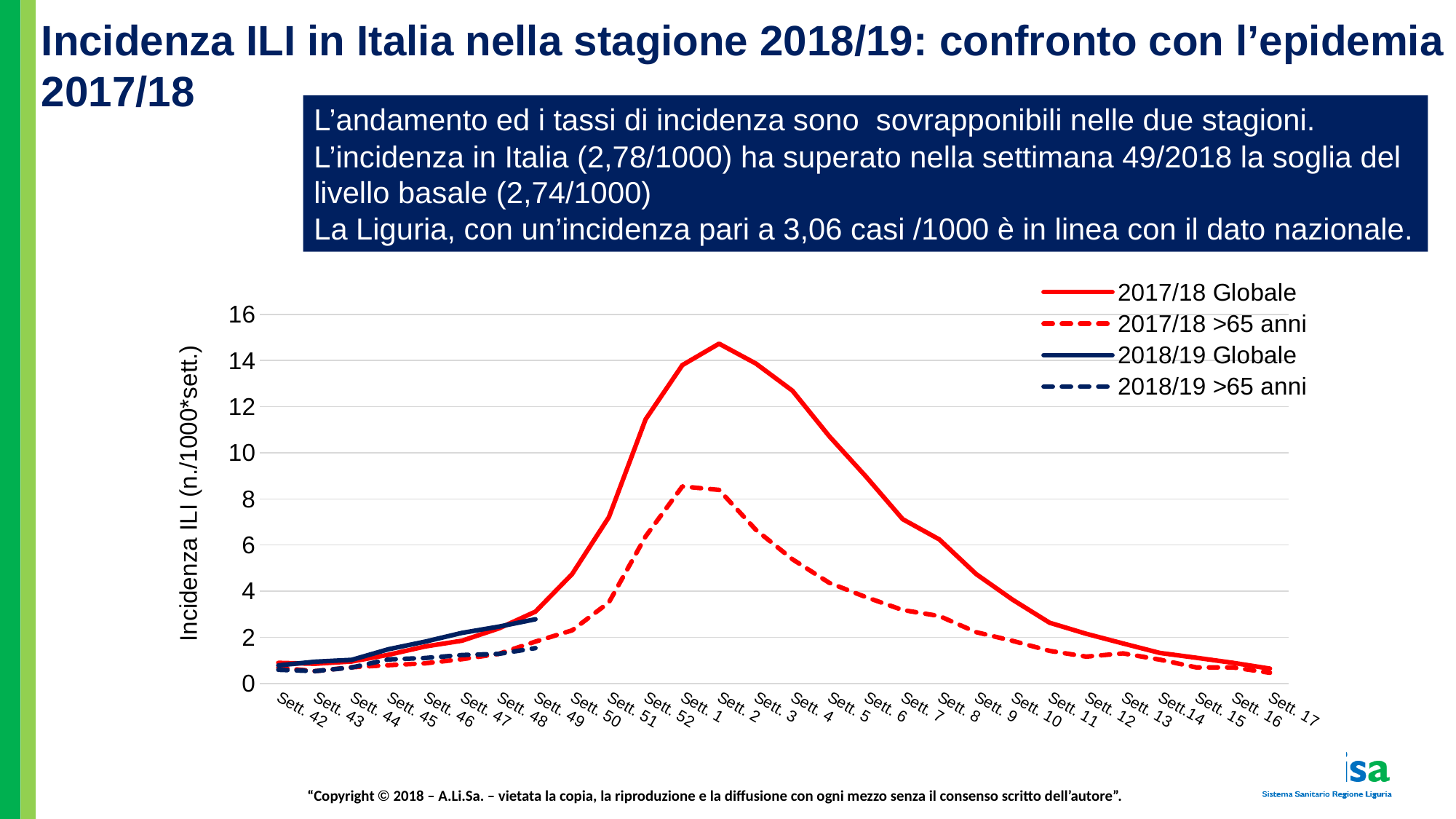
Does the 2018/19 Globale series rise or fall from Sett. 42 to Sett. 48? rise What is the label of the y axis of the chart? Incidenza ILI (n./1000*sett.) At Sett. 1, which series has the larger value: 2017/18 Globale or 2017/18 >65 anni? 2017/18 Globale How many week categories are shown on the x axis of the chart? 28 Is the value of the 2018/19 Globale series at Sett. 48 greater or less than 2? greater Is the value of the 2017/18 >65 anni series at Sett. 52 greater or less than 8? less In which week does the 2017/18 Globale series reach its highest value? Sett. 2 What kind of chart is shown on the slide? line chart How many series does the chart legend list? 4 Does the 2017/18 Globale series rise or fall from Sett. 1 to Sett. 17? fall Is the value of the 2017/18 Globale series at Sett. 6 greater or less than 8? greater